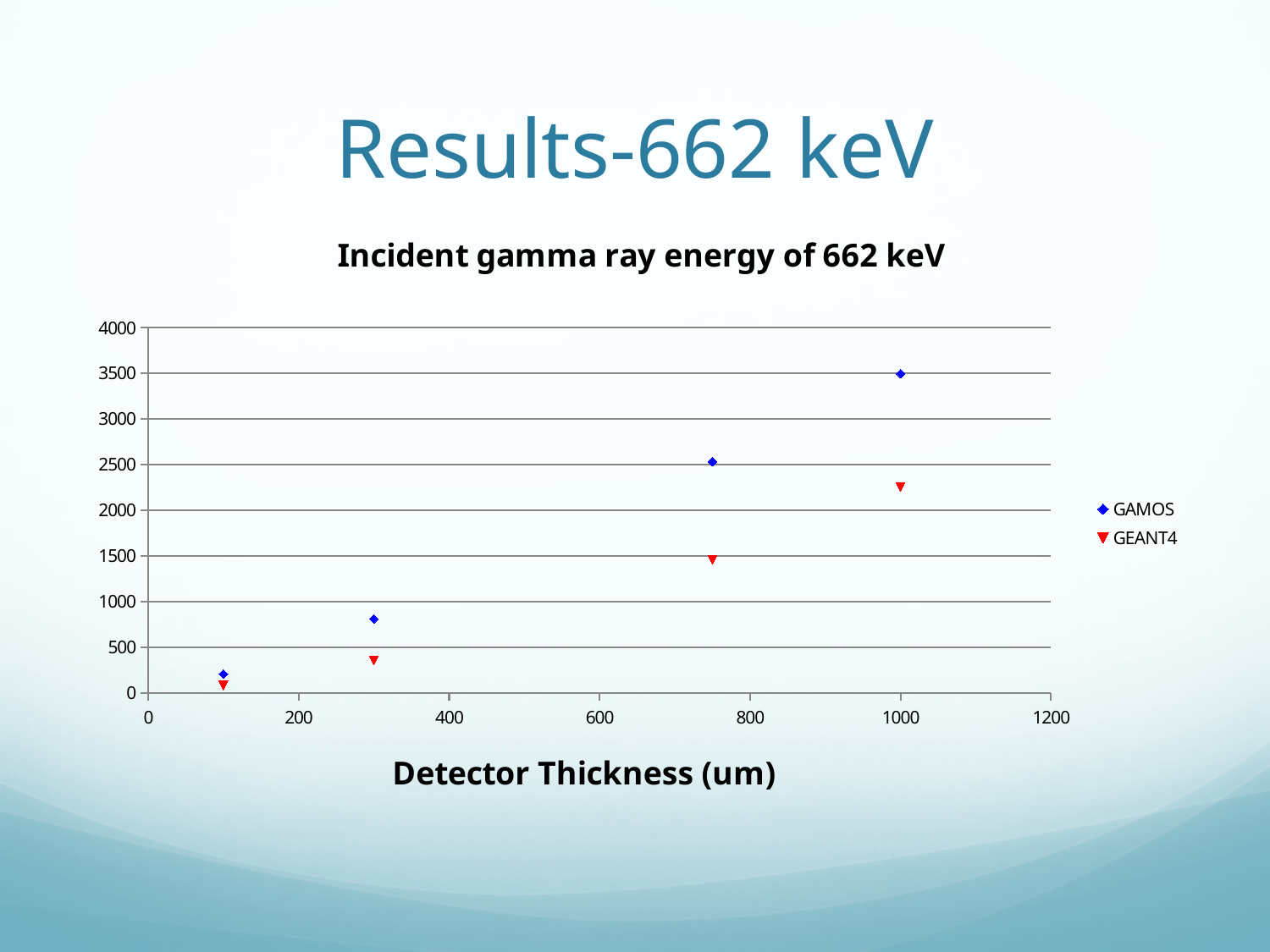
Is the GEANT4 value at a detector thickness of 750 um greater or less than 2000? less Do the GEANT4 values rise or fall as detector thickness increases? rise What kind of chart is shown on the slide? Scatter chart How many data points are plotted for the GAMOS series? 4 Is the GAMOS value at a detector thickness of 750 um greater or less than 2000? greater Which series reaches the highest value on the chart? GAMOS Is the GEANT4 value at a detector thickness of 1000 um greater or less than 2500? less What is the label of the x axis? Detector Thickness (um) How many series does the legend list? 2 At a detector thickness of 1000 um, which series has the larger value, GAMOS or GEANT4? GAMOS